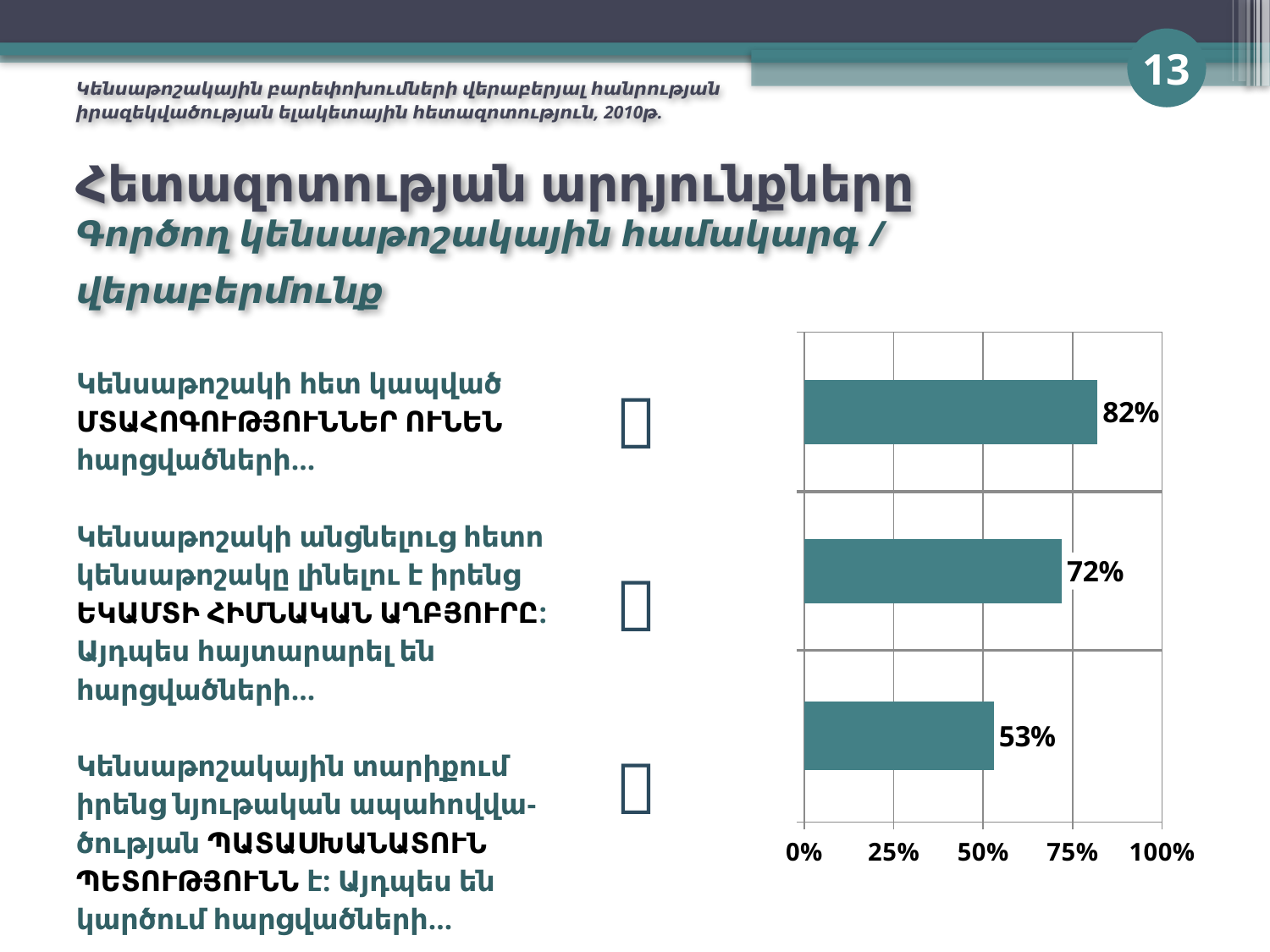
What type of chart is shown on the slide? bar chart What is the value shown on the top bar of the chart? 82% Which bar has the lowest value: top, middle or bottom? bottom What is the value shown on the bottom bar of the chart? 53% Which bar has the highest value: top, middle or bottom? top Is the value of the bottom bar greater or less than 75%? less Which is larger, the middle bar's value or the bottom bar's value? the middle bar's value What is the value shown on the middle bar of the chart? 72% How many bars are plotted in the chart? 3 What is the difference between the top bar's value and the middle bar's value? 10% What is the difference between the top bar's value and the bottom bar's value? 29% What is the maximum value shown on the horizontal axis of the chart? 100%